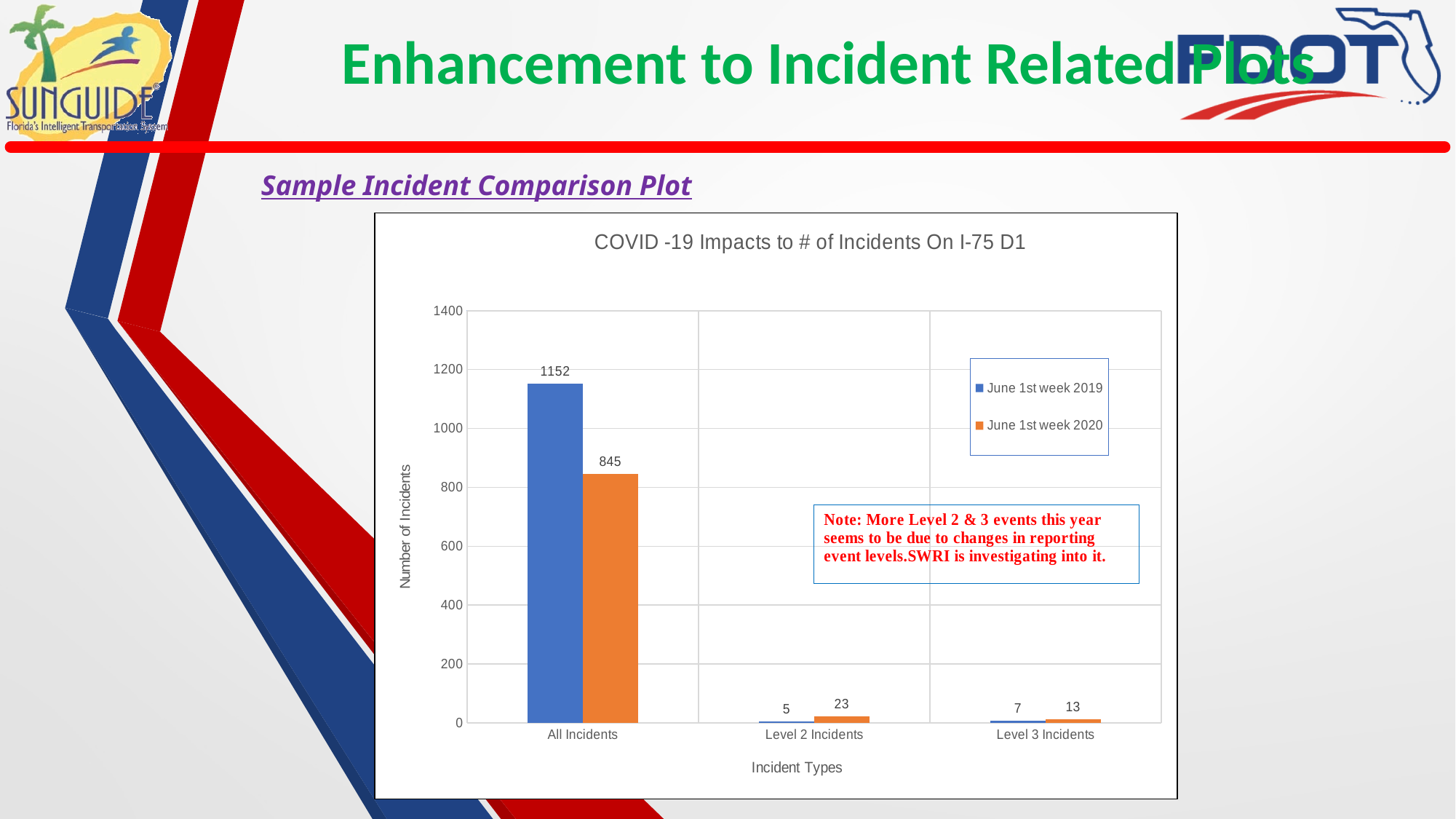
Which is larger for Level 3 Incidents: June 1st week 2019 or June 1st week 2020? June 1st week 2020 What is the value for All Incidents in June 1st week 2019? 1152 What is the value for Level 2 Incidents in June 1st week 2020? 23 What kind of chart is shown on the slide? bar chart What is the value for All Incidents in June 1st week 2020? 845 Is the value for All Incidents in June 1st week 2020 greater or less than 1000? less Which incident type has the highest value for June 1st week 2019? All Incidents What is the value for Level 3 Incidents in June 1st week 2019? 7 Which incident type has the lowest value for June 1st week 2019? Level 2 Incidents How many incident types are shown on the x axis? 3 What is the difference between the June 1st week 2019 and June 1st week 2020 values for All Incidents? 307 How many series does the legend list? 2